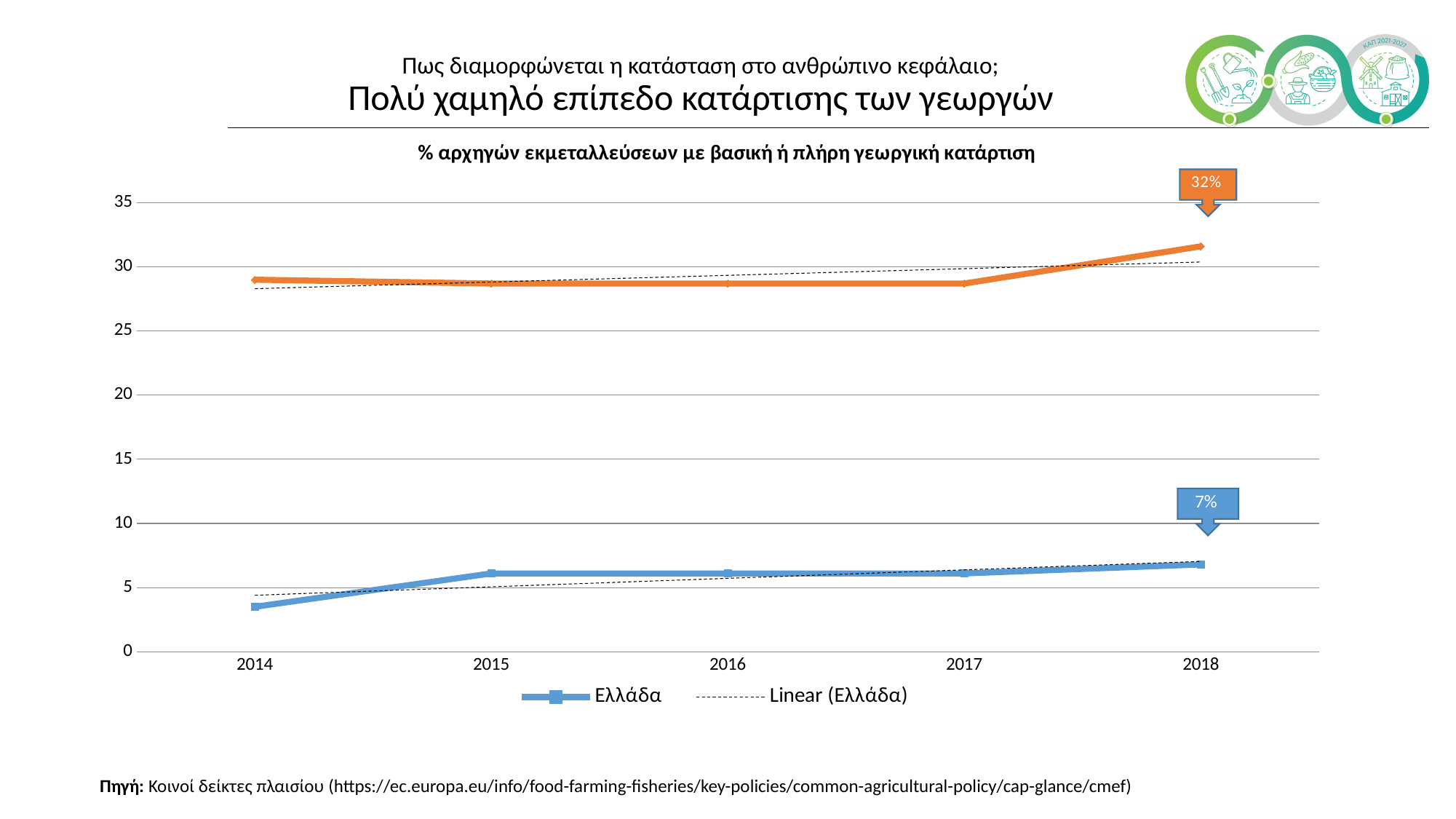
In which year is the Ελλάδα line at its lowest? 2014 Does the Ελλάδα line rise or fall from 2014 to 2018? rises According to the callout label, what is the value for Ελλάδα in 2018? 7% In 2016, which line has the larger value, the orange line or the Ελλάδα line? the orange line Is the value of the orange line in 2014 greater or less than 25? greater What is the title of the chart? % αρχηγών εκμεταλλεύσεων με βασική ή πλήρη γεωργική κατάρτιση What is the difference in percentage points between the orange line's 2018 value (32%) and the Ελλάδα 2018 value (7%)? 25 According to the callout label, what is the value of the orange line in 2018? 32% How many years are shown on the x axis of the chart? 5 What kind of chart is shown on the slide? line chart Is the value for Ελλάδα in 2014 greater or less than 5? less How many entries does the chart legend list? 2